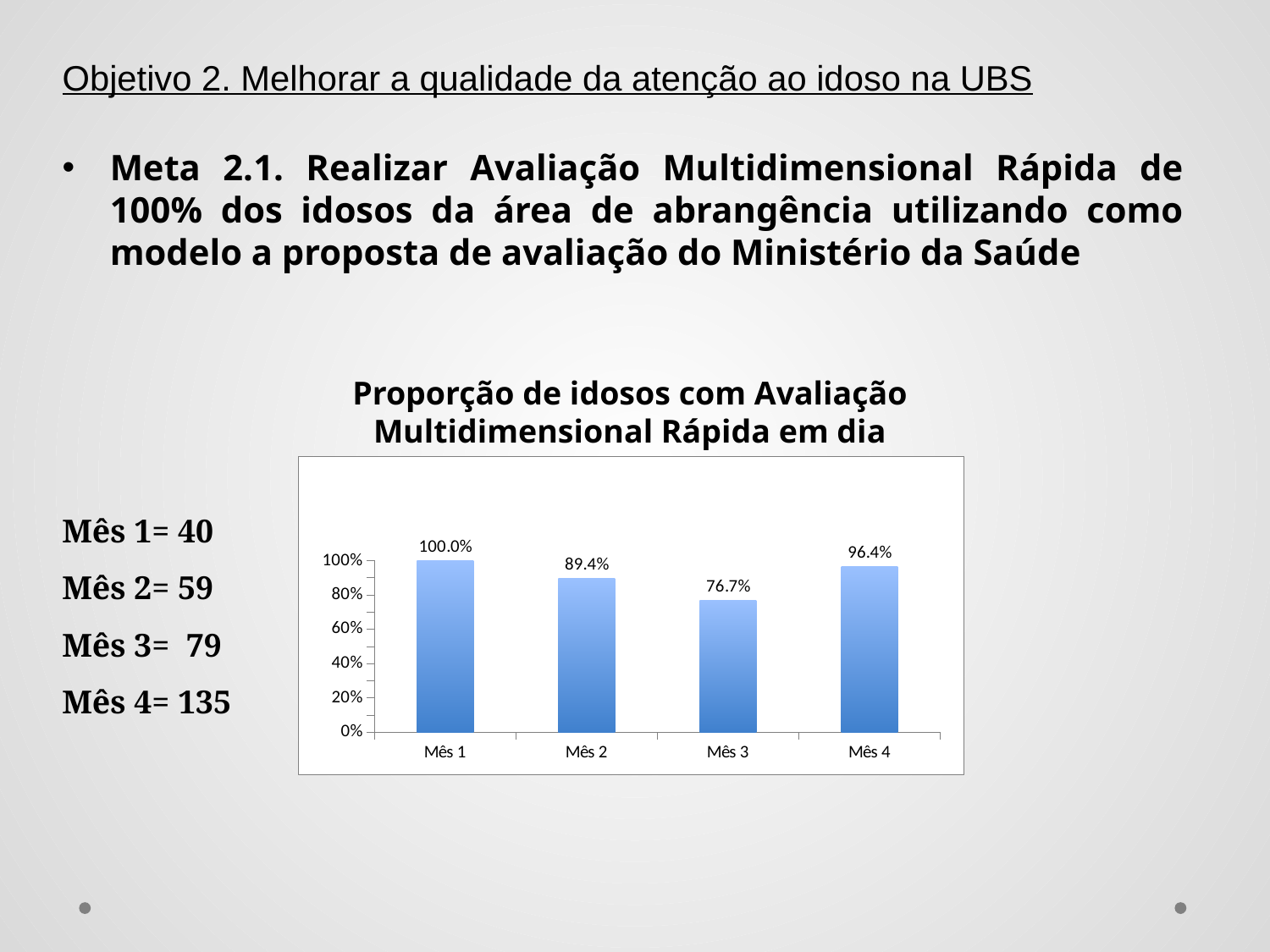
What is the title of the chart? Proporção de idosos com Avaliação Multidimensional Rápida em dia Which month has the highest value? Mês 1 Is the value for Mês 3 greater or less than 80%? less Which month has the lowest value? Mês 3 What is the difference between the values for Mês 4 and Mês 3? 19.7% How many months are shown on the x axis? 4 Which is larger, the value for Mês 2 or the value for Mês 4? Mês 4 What is the value for Mês 4? 96.4% What is the value for Mês 3? 76.7% What is the difference between the values for Mês 1 and Mês 2? 10.6% What is the value for Mês 1? 100.0% What kind of chart is shown on the slide? bar chart